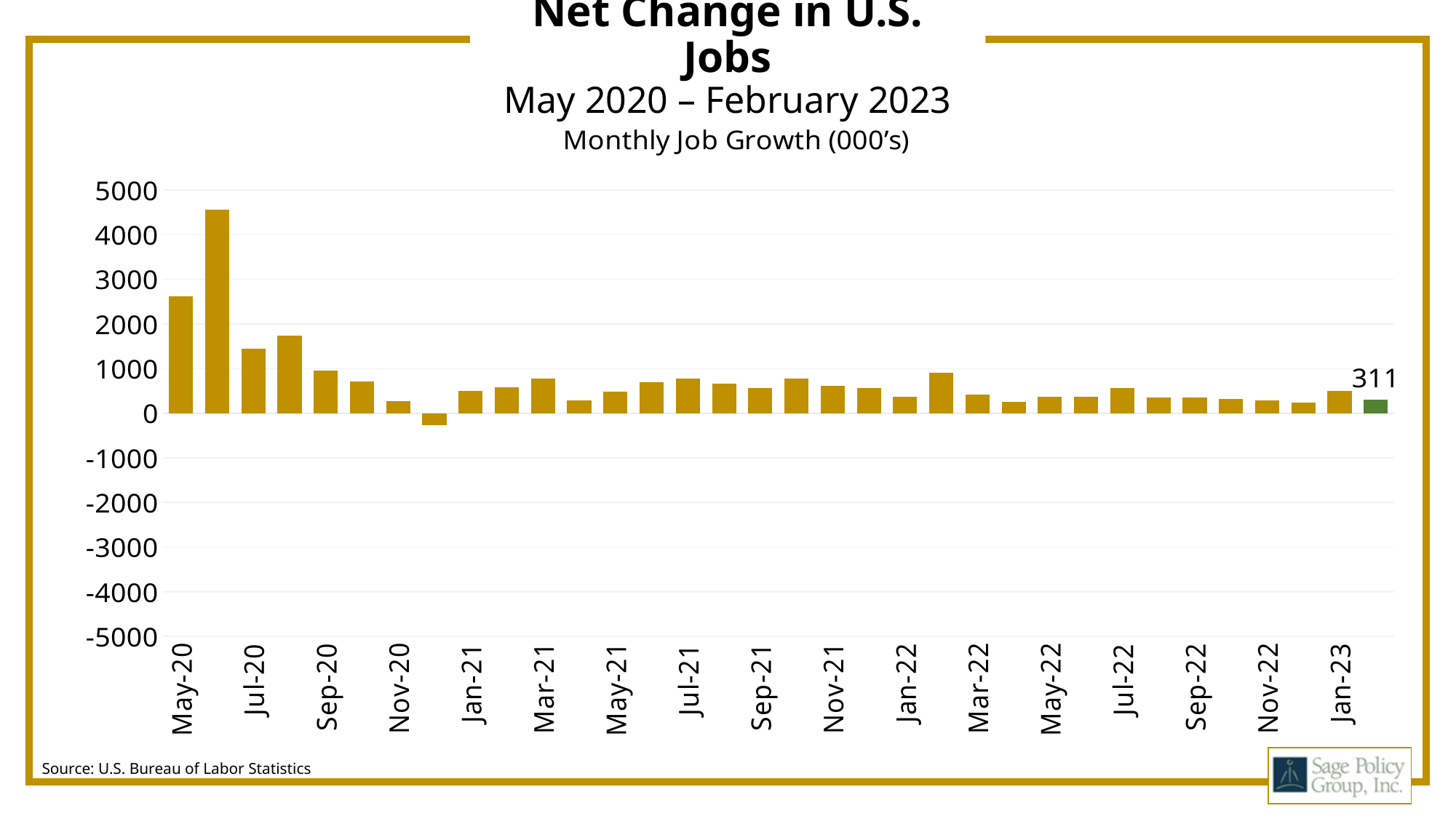
Which month has the lowest net change in jobs? Dec-20 Which is larger, the value for May-20 or the value for Jul-20? May-20 What source is cited for the chart's data? U.S. Bureau of Labor Statistics Overall, do the monthly job growth values rise or fall from May 2020 to February 2023? fall Is the value for Dec-20 greater or less than 0? less What kind of chart is shown on the slide? bar chart Is the value for Aug-20 greater or less than 1000? greater How many monthly bars are plotted in the chart? 34 What is the value of the data label shown on the last bar (Feb-23)? 311 Is the value for Jun-20 greater or less than 4000? greater Which month has the highest net change in jobs? Jun-20